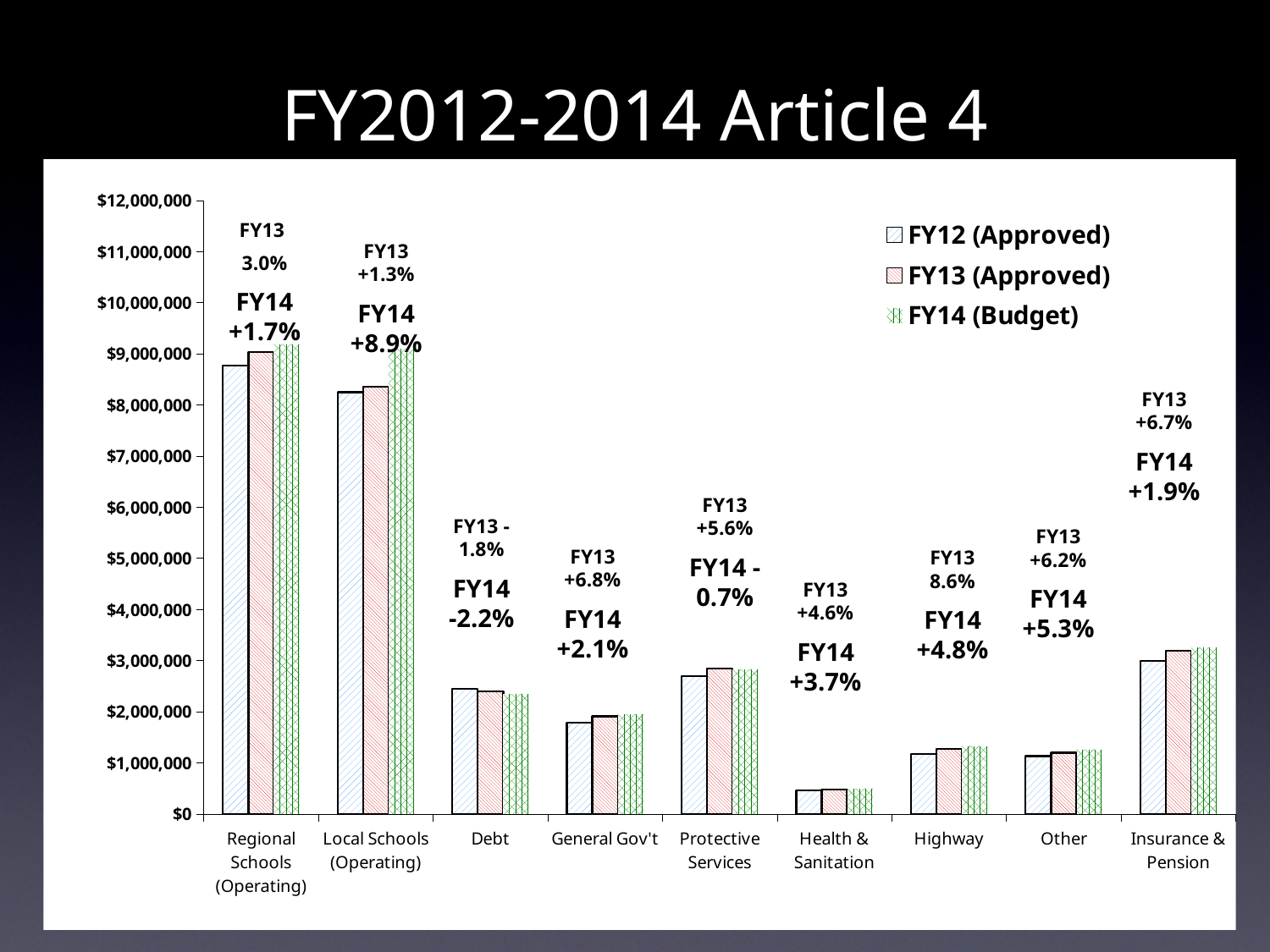
Is the FY14 (Budget) value for Health & Sanitation greater or less than $1,000,000? less How many categories are shown along the x axis of the chart? 9 What FY14 percentage change is annotated above the Local Schools (Operating) bars? +8.9% How many series does the chart's legend list? 3 Which category has the highest FY13 (Approved) value? Regional Schools (Operating) Which category has the lowest FY14 (Budget) value? Health & Sanitation What kind of chart is shown on the slide? bar chart Which is larger: the FY12 (Approved) value for Debt or the FY12 (Approved) value for General Gov't? Debt What FY14 percentage change is annotated above the Debt bars? -2.2% Is the FY13 (Approved) value for Protective Services greater or less than $3,000,000? less Is the FY12 (Approved) value for Debt greater or less than $2,000,000? greater What is the title of the slide? FY2012-2014 Article 4